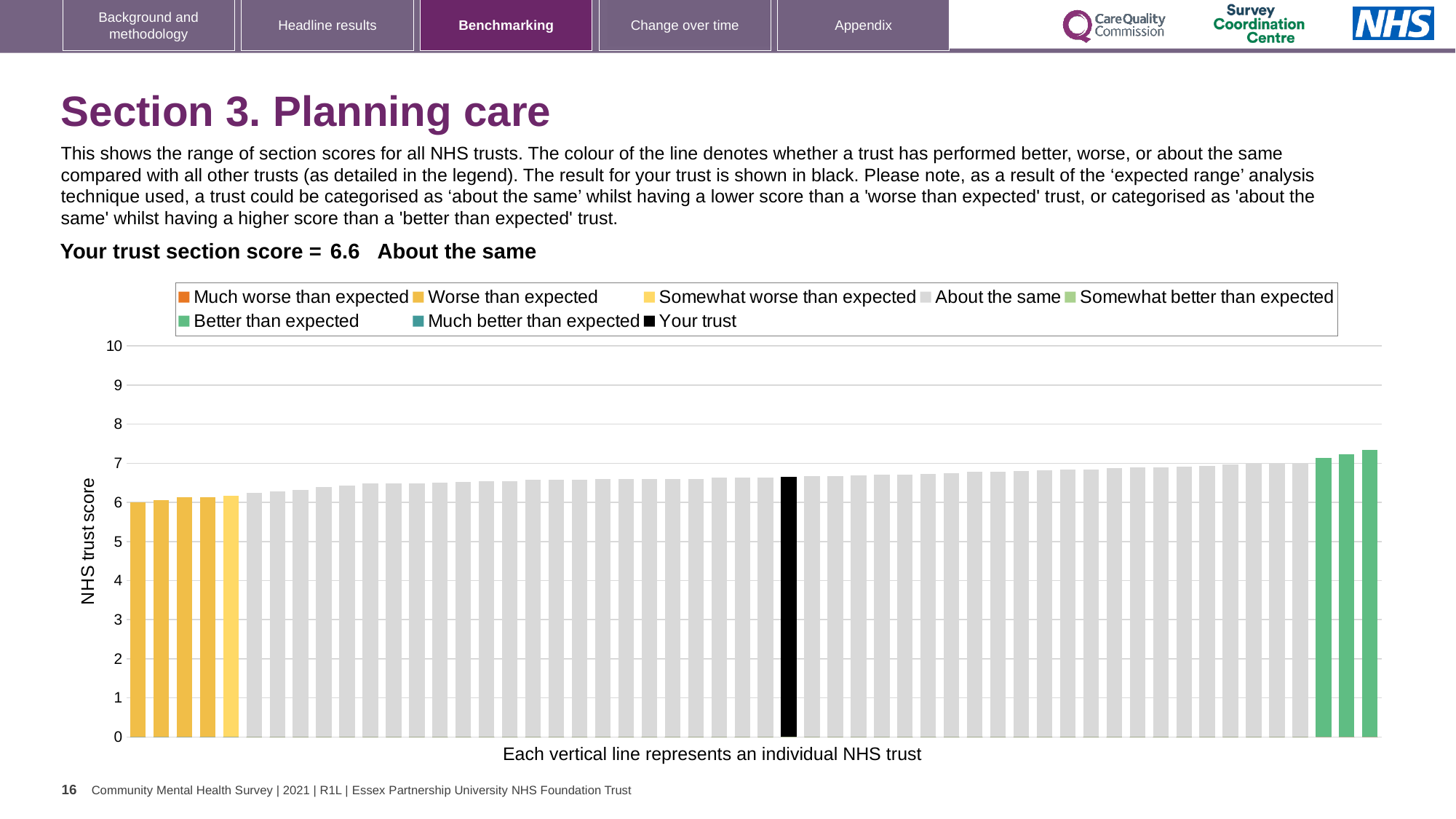
How many entries does the chart legend list? 8 What is the section score for your trust shown on the slide? 6.6 How many bars on the chart are coloured green? 3 What is the title of the vertical axis? NHS trust score Is the value of the tallest bar greater or less than 7? greater What kind of chart is shown on the slide? bar chart Is the value of the black bar (your trust) greater or less than 5? greater Do the bar values rise or fall from left to right along the x axis? rise Is the value of the shortest bar greater or less than 7? less Which category is your trust placed in according to the text above the chart? About the same Is the black bar for your trust taller or shorter than the green bars at the right of the chart? shorter